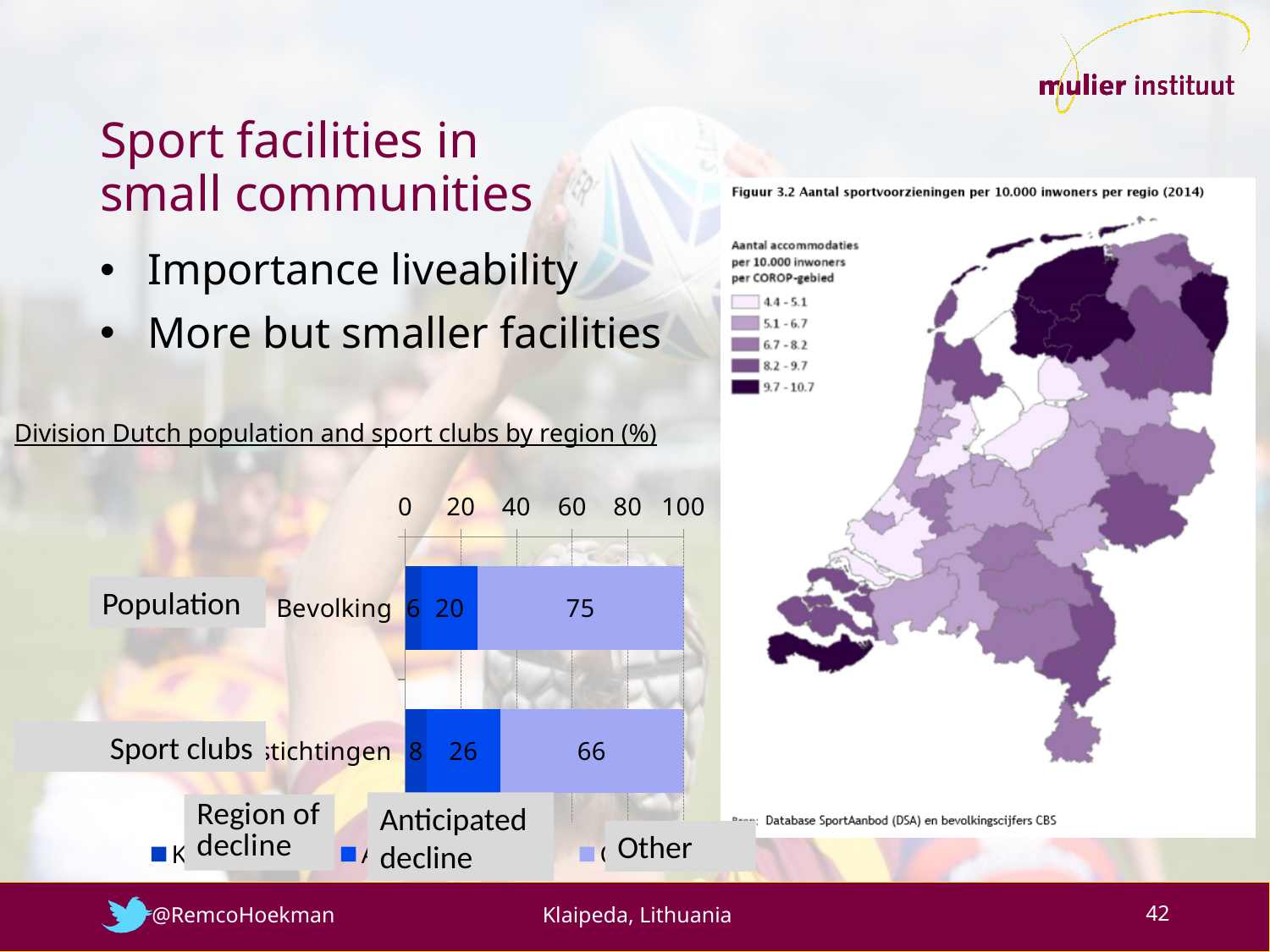
In the 'Division Dutch population and sport clubs by region (%)' chart, what is the value of 'Other' for Population? 75 How many series does the legend of the 'Division Dutch population and sport clubs by region (%)' chart list? 3 In the 'Division Dutch population and sport clubs by region (%)' chart, what is the total of the Sport clubs bar? 100 In the 'Division Dutch population and sport clubs by region (%)' chart, which series has the largest value for Sport clubs? Other In the 'Division Dutch population and sport clubs by region (%)' chart, what is the difference between the 'Other' values for Population and Sport clubs? 9 In the 'Division Dutch population and sport clubs by region (%)' chart, which has the larger 'Other' value, Population or Sport clubs? Population In the 'Division Dutch population and sport clubs by region (%)' chart, what is the value of 'Region of decline' for Population? 6 In the 'Division Dutch population and sport clubs by region (%)' chart, what is the value of 'Other' for Sport clubs? 66 In the 'Division Dutch population and sport clubs by region (%)' chart, what is the value of 'Anticipated decline' for Sport clubs? 26 How many categories (bars) does the 'Division Dutch population and sport clubs by region (%)' chart show? 2 What kind of chart is the 'Division Dutch population and sport clubs by region (%)' chart? Stacked bar chart In the 'Division Dutch population and sport clubs by region (%)' chart, what is the difference between the 'Anticipated decline' values for Sport clubs and Population? 6